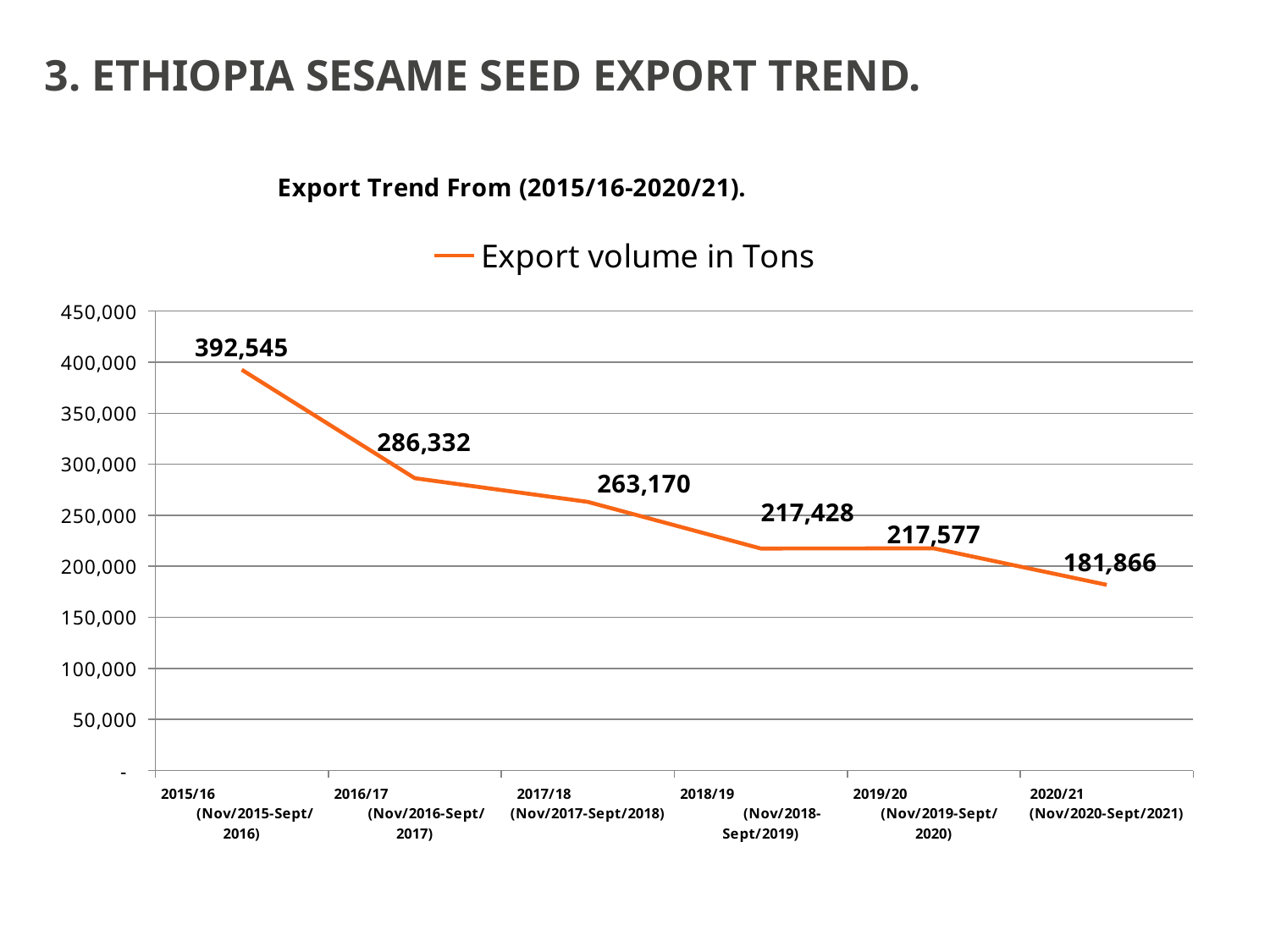
How many series does the legend list? 1 What is the export volume in tons for 2015/16? 392,545 What is the export volume in tons for 2017/18? 263,170 What is the difference in export volume between 2019/20 and 2020/21? 35,711 What is the export volume in tons for 2020/21? 181,866 How many years are plotted on the chart? 6 Which is larger, the export volume for 2016/17 or for 2017/18? 2016/17 Which year has the highest export volume? 2015/16 What is the difference in export volume between 2015/16 and 2016/17? 106,213 Does the export volume generally rise or fall from 2015/16 to 2020/21? Fall Which year has the lowest export volume? 2020/21 What kind of chart is shown on the slide? Line chart